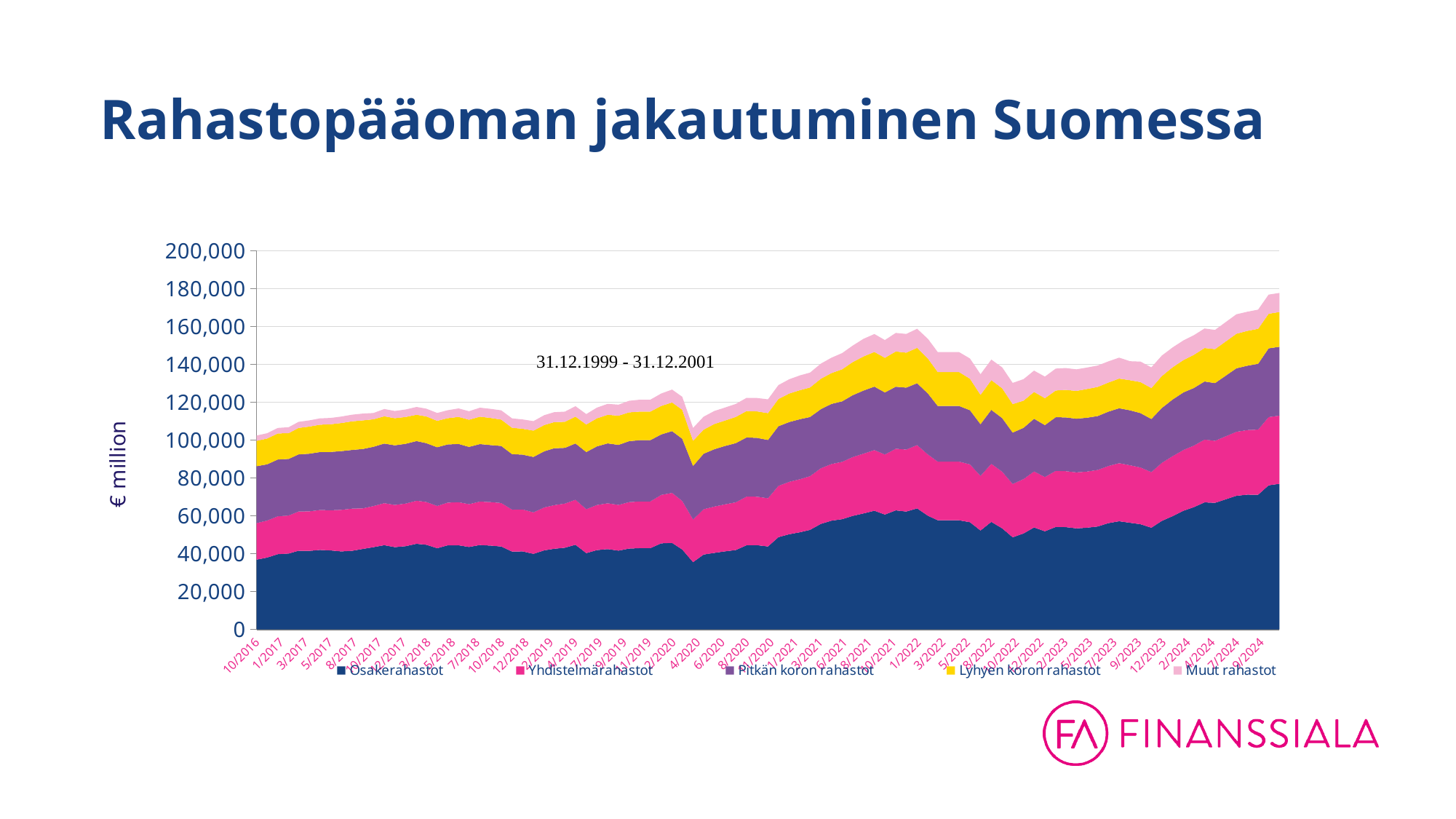
Is the total stacked value at 10/2016 greater or less than 120,000? less At which point on the x axis is the total stacked value highest? 9/2024 What kind of chart is shown on the slide? Stacked area chart Is the total stacked value at 4/2020 greater or less than 120,000? less Is the total stacked value at 10/2021 greater or less than 140,000? greater What unit is shown on the vertical axis label? € million Which is larger at 9/2024: the value for Osakerahastot or the value for Muut rahastot? Osakerahastot What is the title of the chart? Rahastopääoman jakautuminen Suomessa How many series does the legend list? 5 Does the total stacked value generally rise or fall from 10/2016 to 9/2024? rise